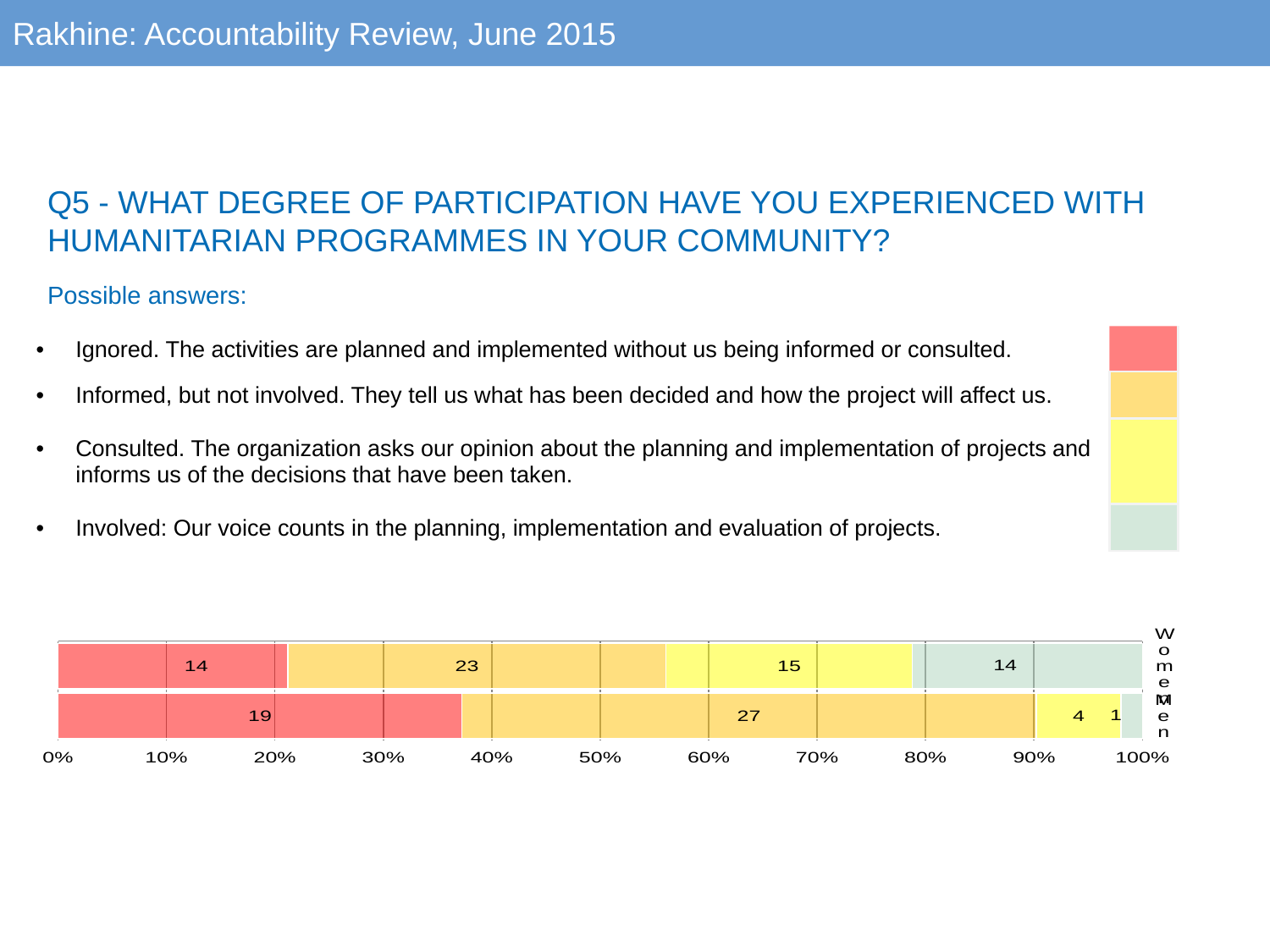
What is the total of the values in the Women bar? 66 What is the difference between the orange segment values for Men and Women? 4 What value is shown on the orange segment of the Men bar? 27 What value is shown on the red segment of the Women bar? 14 Which segment of the Men bar has the smallest value? The green segment (1) Which bar has the larger yellow segment value, Women or Men? Women What value is shown on the yellow segment of the Men bar? 4 What is the total of the values in the Men bar? 51 Which segment of the Men bar has the largest value? The orange segment (27) What value is shown on the green segment of the Women bar? 14 How many bars (respondent groups) does the chart show? 2 What type of chart is shown on the slide? Stacked bar chart